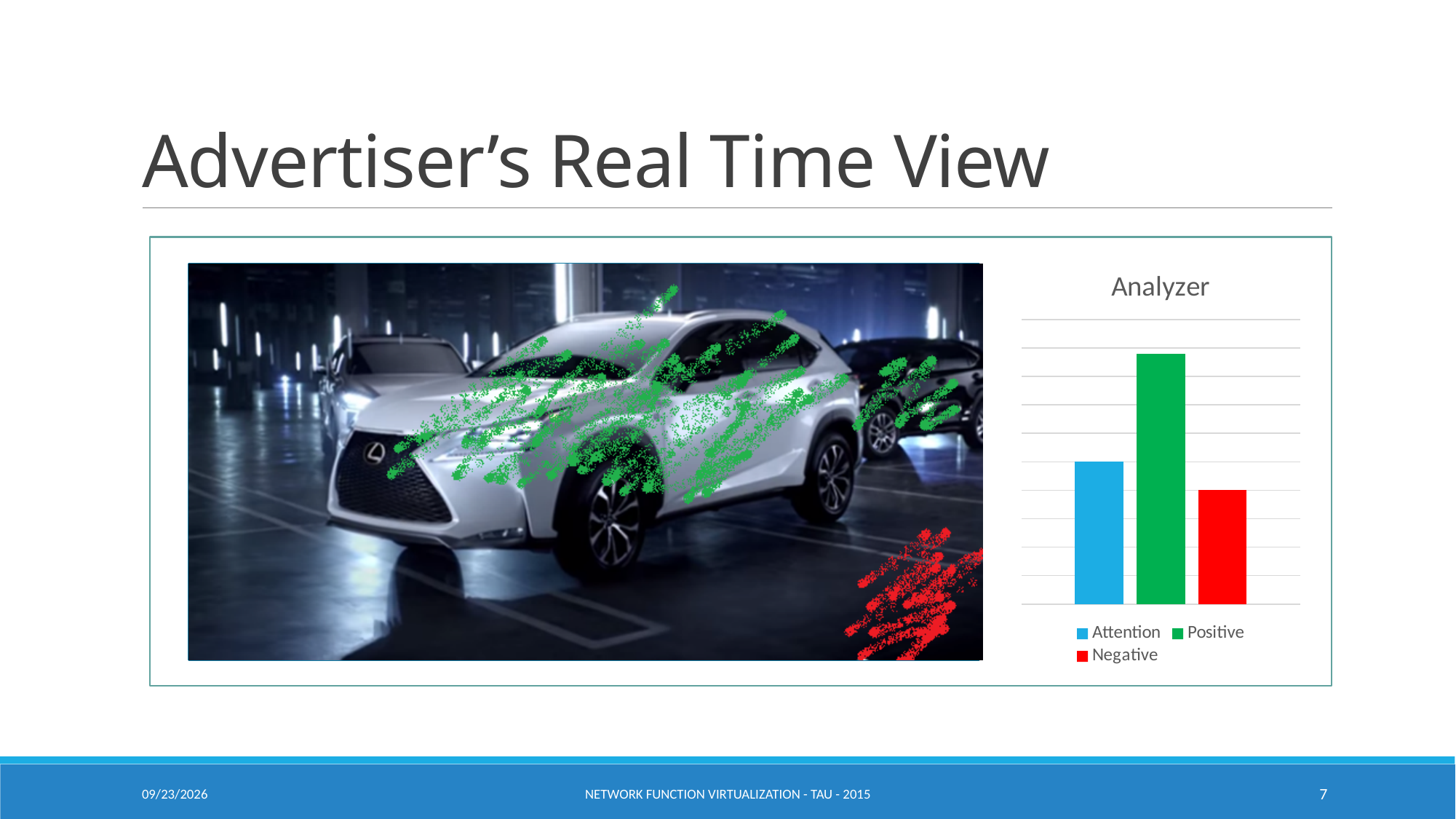
Which series has the shortest bar in the Analyzer chart? Negative In the Analyzer chart, which is larger, Attention or Negative? Attention Which series in the Analyzer chart is shown in red? Negative What colour is the Positive bar in the Analyzer chart? green How many series does the legend of the Analyzer chart list? 3 Which series has the tallest bar in the Analyzer chart? Positive In the Analyzer chart, which is larger, Positive or Attention? Positive How many bars are plotted in the Analyzer chart? 3 What is the title of the chart on the slide? Analyzer What kind of chart is shown under the title "Analyzer"? bar chart